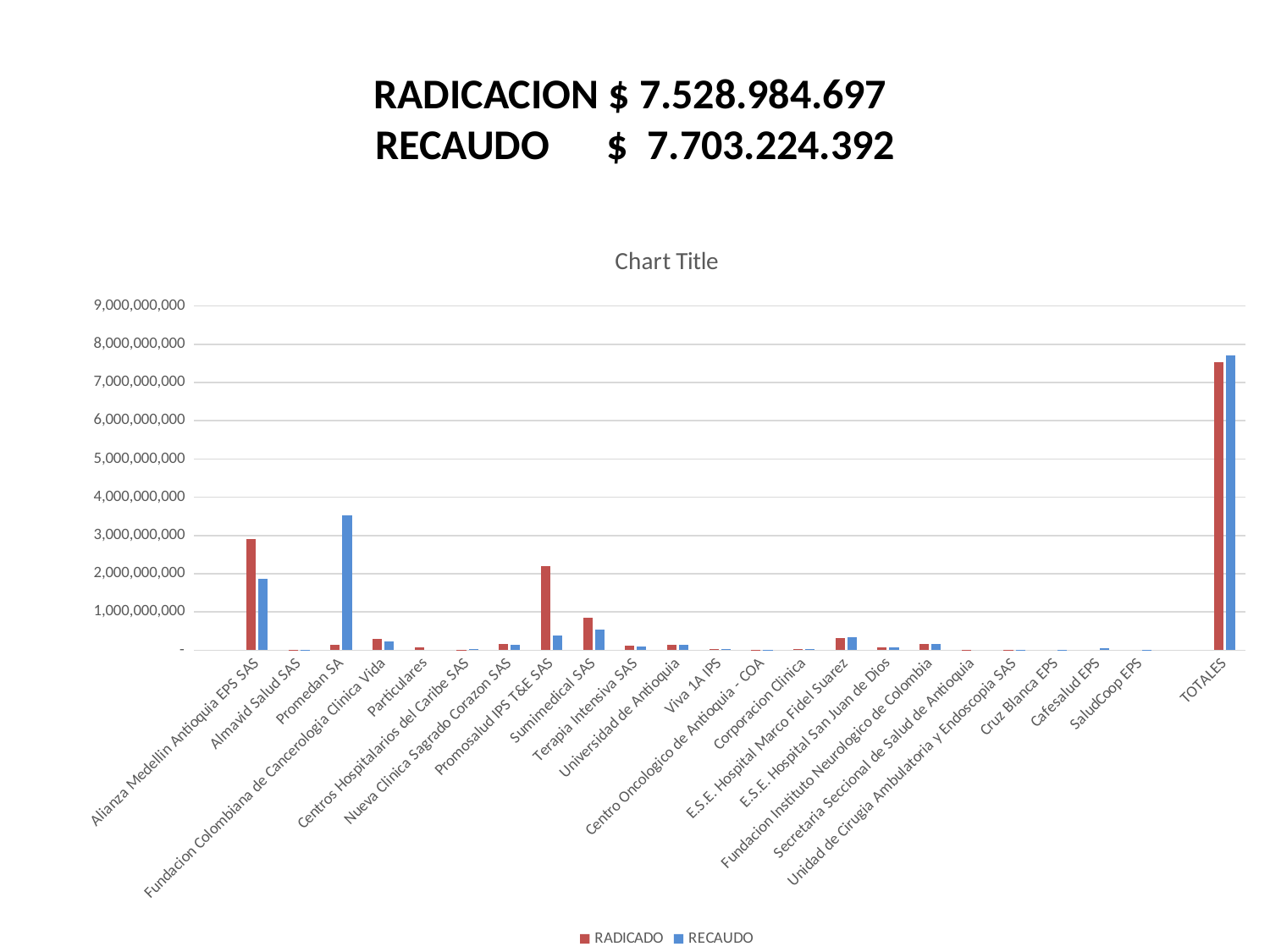
Excluding TOTALES, which category has the highest RADICADO value? Alianza Medellin Antioquia EPS SAS Is the RADICADO value for Alianza Medellin Antioquia EPS SAS greater or less than 2,000,000,000? greater How many categories are shown along the x axis of the chart? 23 Is the RECAUDO value for Promedan SA greater or less than 3,000,000,000? greater What are the two series named in the chart legend? RADICADO and RECAUDO How many series does the chart legend list? 2 For Promedan SA, which is larger: the RADICADO value or the RECAUDO value? RECAUDO Excluding TOTALES, which category has the highest RECAUDO value? Promedan SA What kind of chart is shown on the slide? Bar chart Is the RECAUDO value for TOTALES greater or less than 7,000,000,000? greater Which colour represents the RECAUDO series in the chart? Blue